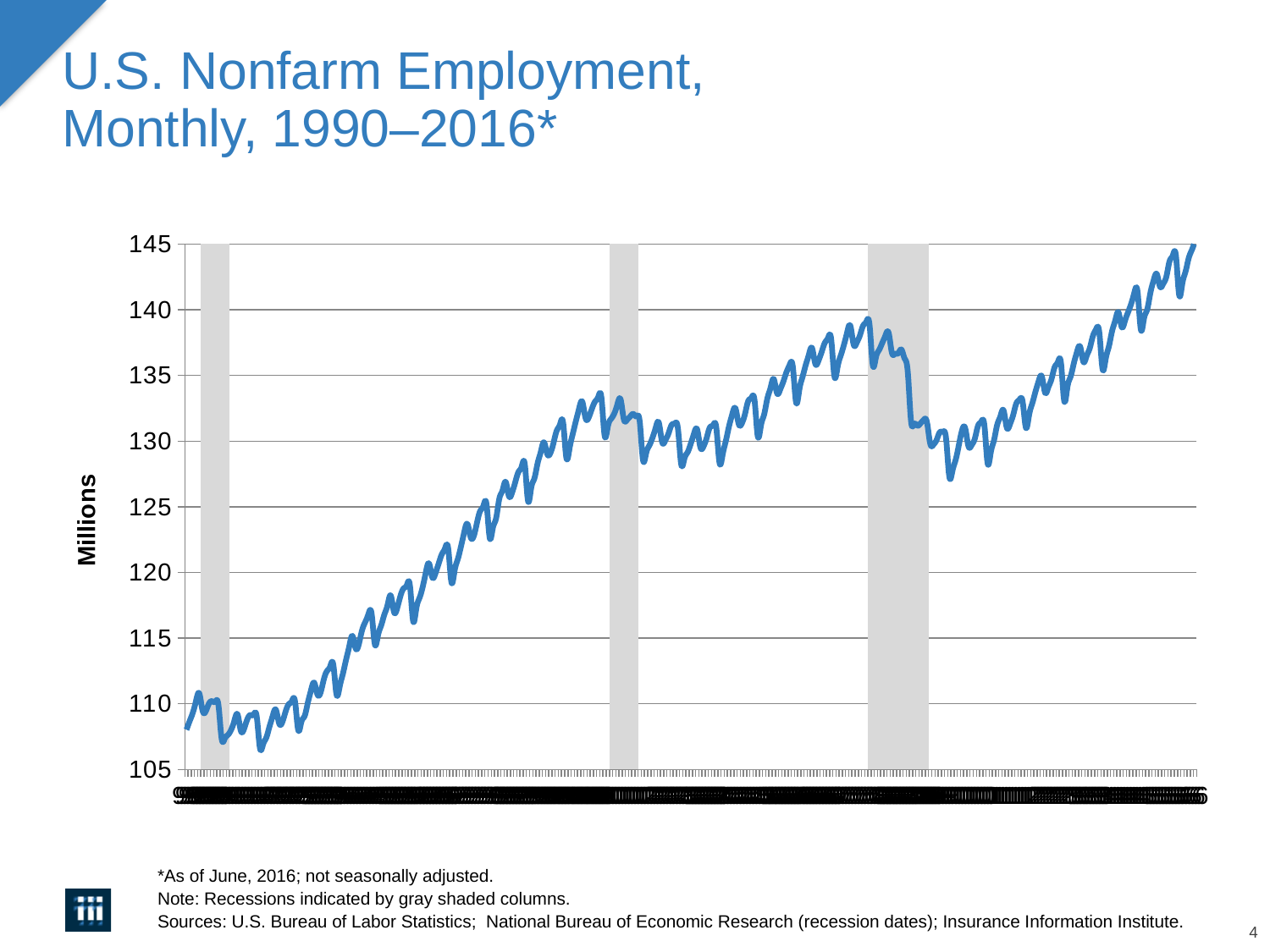
How many gray shaded recession columns are shown on the chart? 3 What is the label on the vertical axis of the chart? Millions How many data series are plotted on the chart? 1 What kind of chart is shown on the slide? line chart What is the lowest value shown on the vertical axis? 105 Over the whole period shown, does U.S. nonfarm employment generally rise or fall along the x axis? rise Is the value at the end of the series (2016) greater or less than 140? greater Is the highest point of the line greater or less than 140? greater Is the value at the start of the series (1990) greater or less than 110? less What is the title of the chart? U.S. Nonfarm Employment, Monthly, 1990–2016*